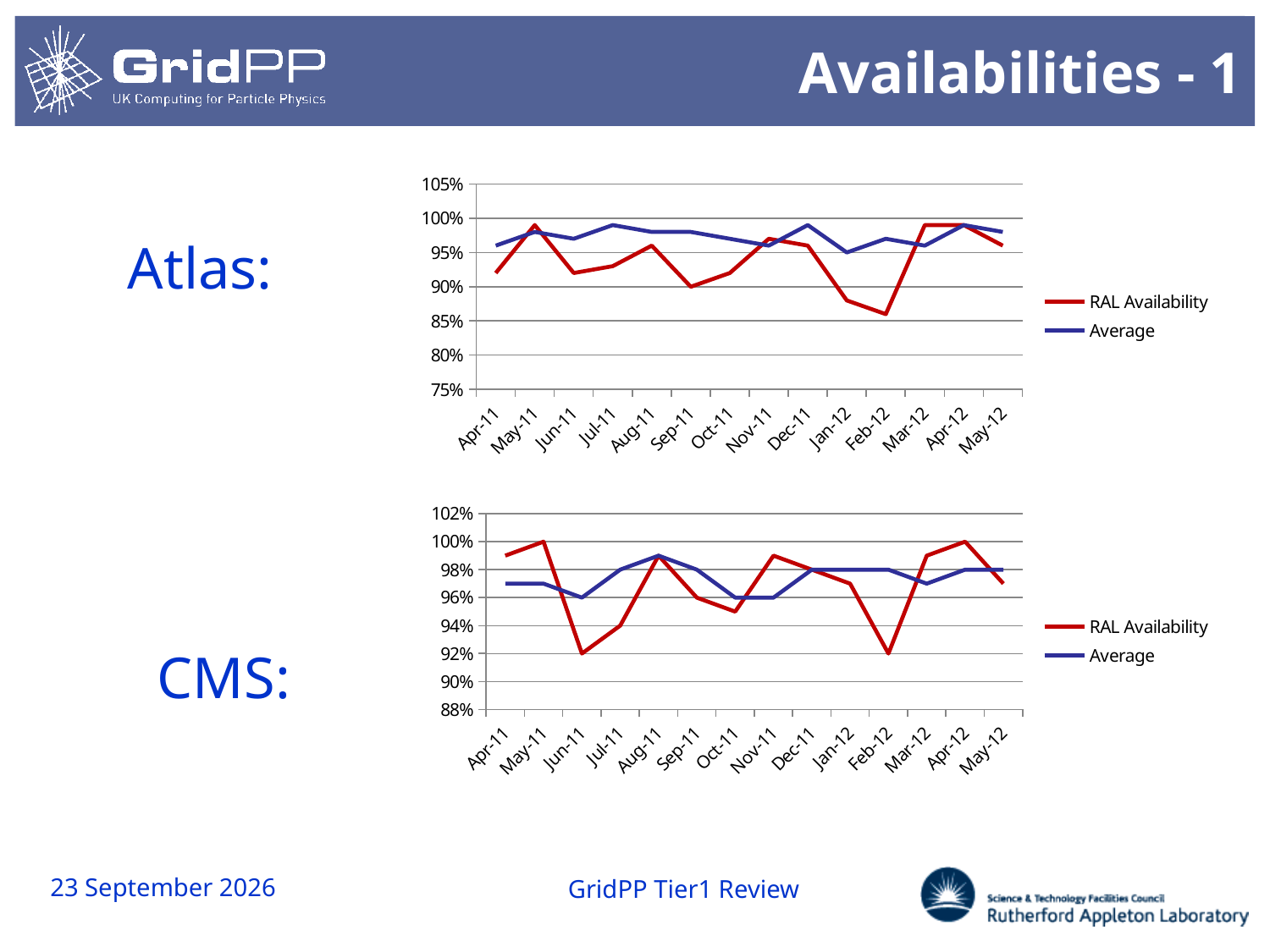
In the Atlas chart, in which month is RAL Availability lowest? Feb-12 How many series does the legend of the CMS chart list? 2 What kind of chart is the Atlas chart? line chart In the CMS chart, what is the RAL Availability for Jun-11? 92% In the Atlas chart, is the RAL Availability for Feb-12 greater or less than 90%? less In the CMS chart, what is the RAL Availability for May-11? 100% What are the two legend entries in the Atlas chart? RAL Availability and Average In the Atlas chart, which is larger for Feb-12, RAL Availability or Average? Average In the Atlas chart, is the RAL Availability for Jan-12 greater or less than 90%? less How many months are plotted along the x axis of the Atlas chart? 14 In the CMS chart, is the RAL Availability for Feb-12 greater or less than 94%? less In the CMS chart, which is larger for Jun-11, RAL Availability or Average? Average